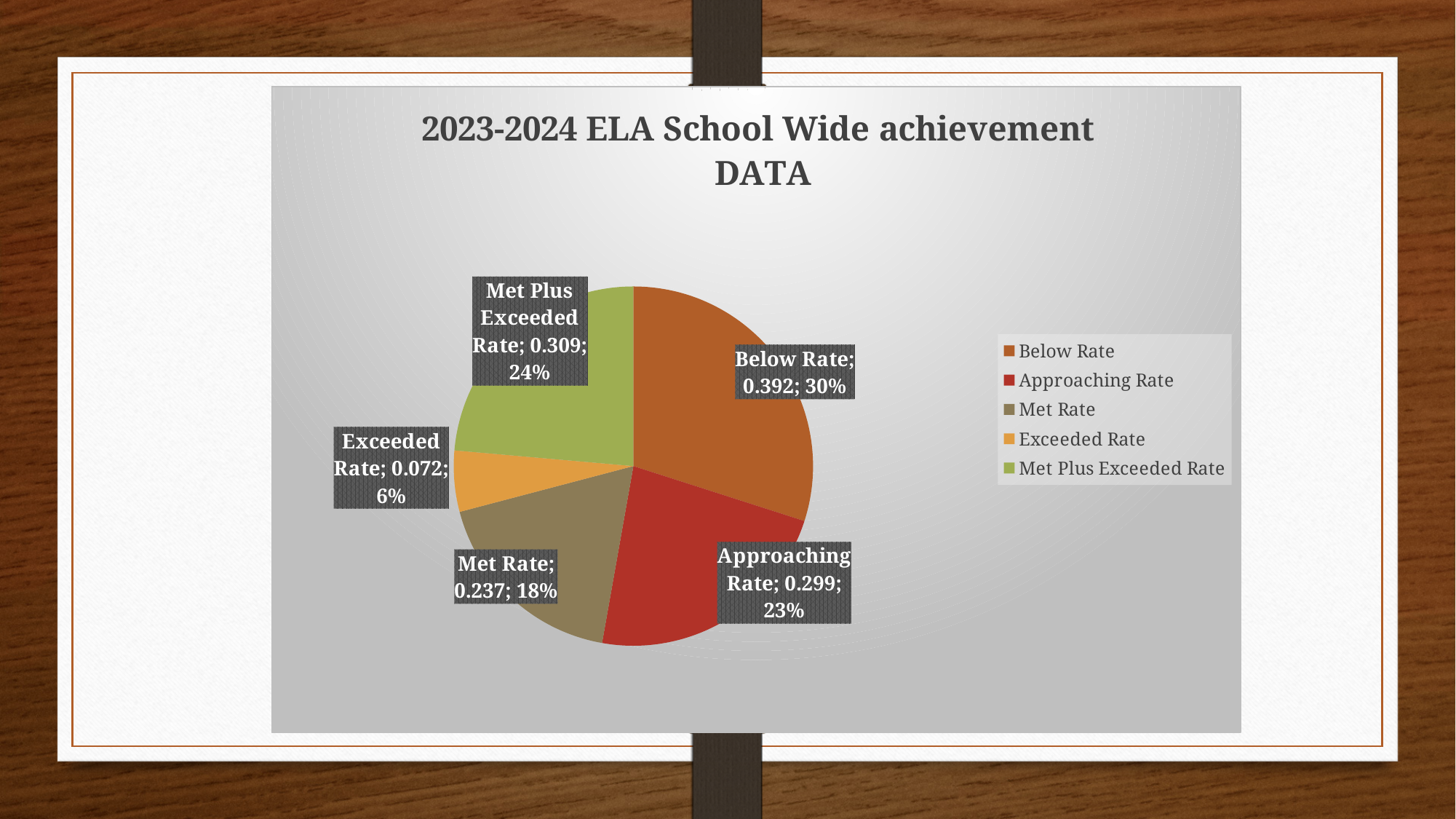
Which is larger, the value for Met Rate or the value for Met Plus Exceeded Rate? Met Plus Exceeded Rate How many categories are shown in the pie chart? 5 What is the value for Exceeded Rate? 0.072 What percentage share of the pie does Met Plus Exceeded Rate have? 24% What is the value for Below Rate? 0.392 What is the value for Met Rate? 0.237 What percentage share of the pie does Exceeded Rate have? 6% What type of chart is shown on the slide? pie chart What is the title of the chart? 2023-2024 ELA School Wide achievement DATA Which category has the largest slice of the pie? Below Rate Which category has the smallest slice of the pie? Exceeded Rate What is the value for Approaching Rate? 0.299